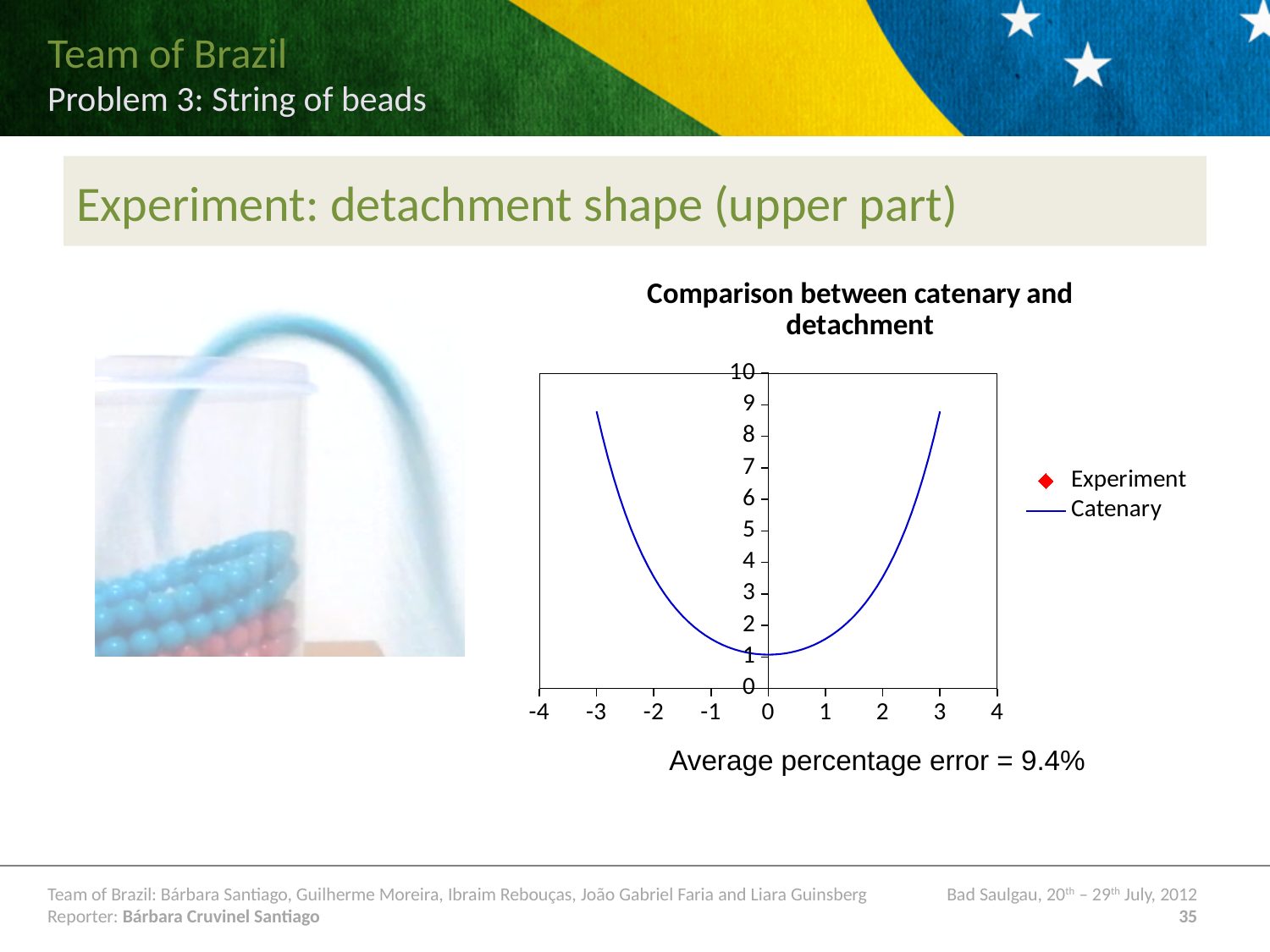
What average percentage error is stated below the chart? 9.4% Is the value of the Catenary curve at x = -2 greater or less than 2? greater Is the value of the Catenary curve at x = 0 greater or less than 2? less How many series does the legend of the chart list? 2 Is the value of the Catenary curve at x = 1 greater or less than 3? less At which x value does the Catenary curve reach its lowest point? 0 Does the Catenary curve rise or fall as x goes from 0 to 3? rise Which is larger on the Catenary curve: the value at x = 3 or the value at x = 1? the value at x = 3 Does the Catenary curve rise or fall as x goes from -3 to 0? fall What kind of chart is shown on the slide? line chart What is the title of the chart? Comparison between catenary and detachment